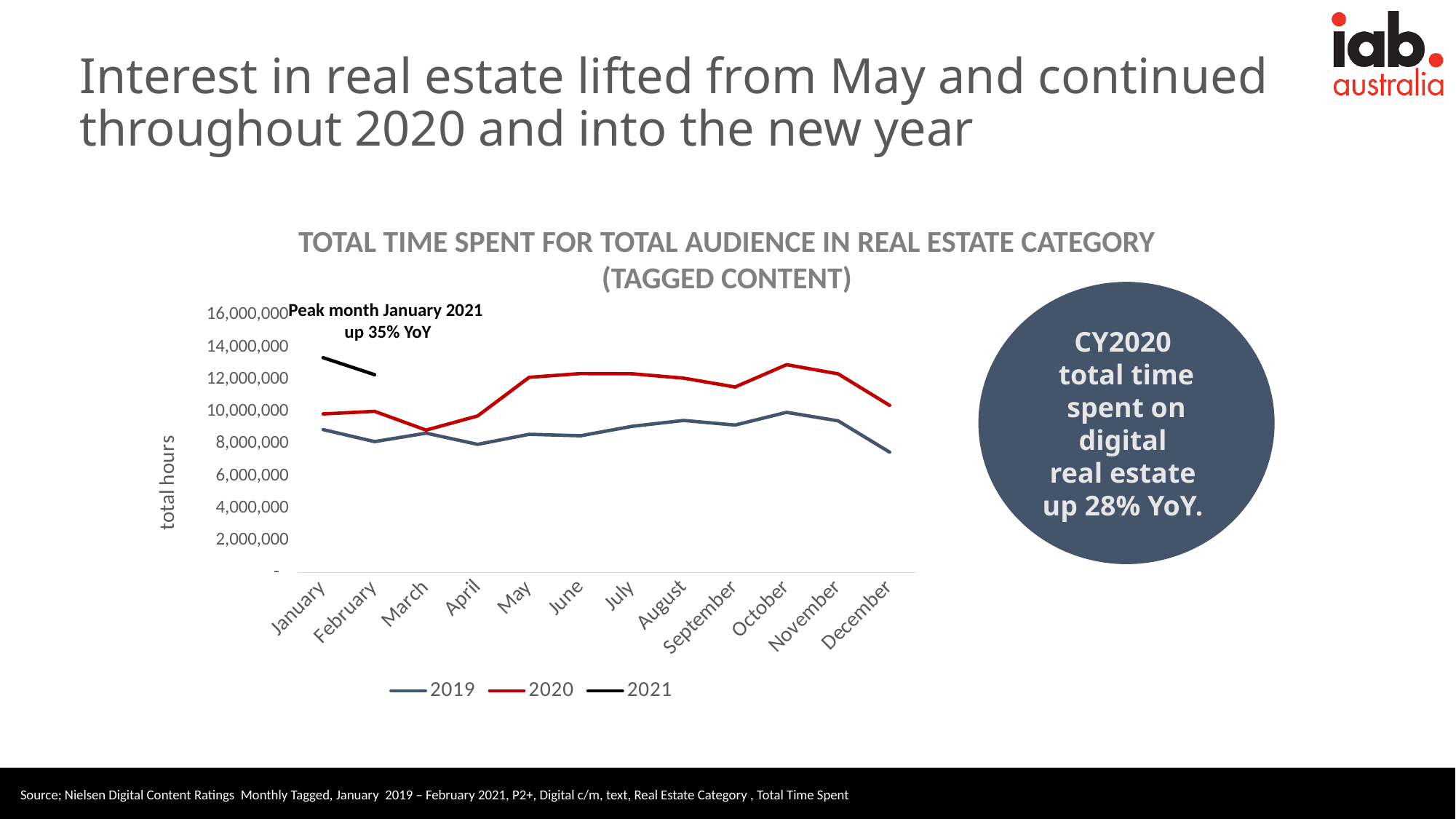
How many months are shown along the x axis of the chart? 12 Is the 2020 value for May greater or less than 10,000,000? greater Which series has the larger value in May, 2019 or 2020? 2020 Is the 2020 value for October greater or less than 12,000,000? greater How many series does the chart legend list? 3 In which month does the 2019 series reach its lowest value? December Is the 2019 value for December greater or less than 8,000,000? less In which month does the 2020 series reach its highest value? October What kind of chart is shown on the slide? line chart Does the 2020 series rise or fall from March to May? rise What colour is the line for the 2020 series? red In which month does the 2020 series reach its lowest value? March